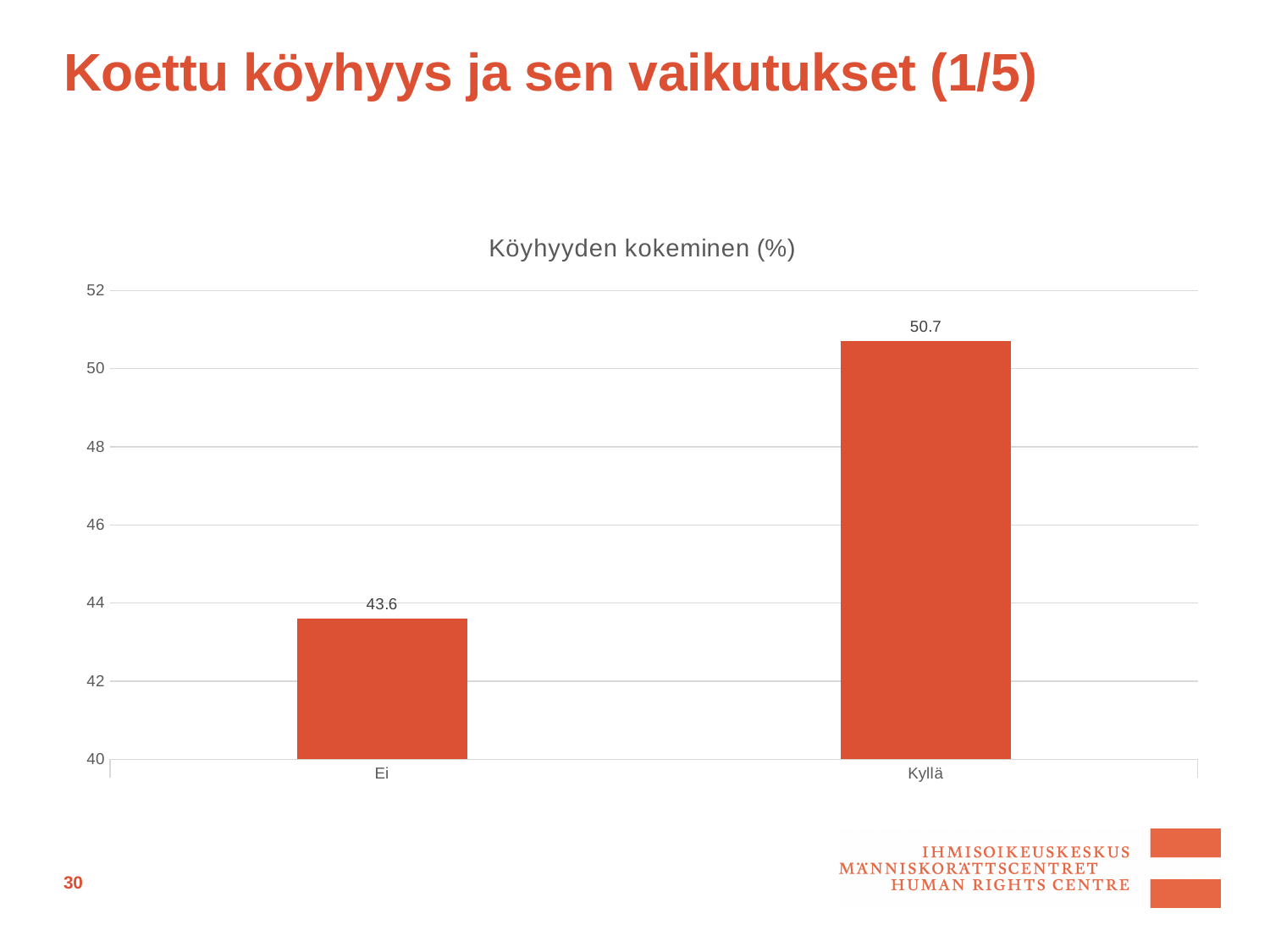
Which is larger, the value for Ei or the value for Kyllä? Kyllä What is the difference between the values for Kyllä and Ei? 7.1 What is the value for Ei? 43.6 What kind of chart is shown on the slide? bar chart What is the title of the chart? Köyhyyden kokeminen (%) Which category has the lowest value? Ei Is the value for Ei greater or less than 44? less How many categories are shown on the x axis? 2 What is the value for Kyllä? 50.7 Is the value for Kyllä greater or less than 50? greater What is the highest value shown on the y axis? 52 Which category has the highest value? Kyllä